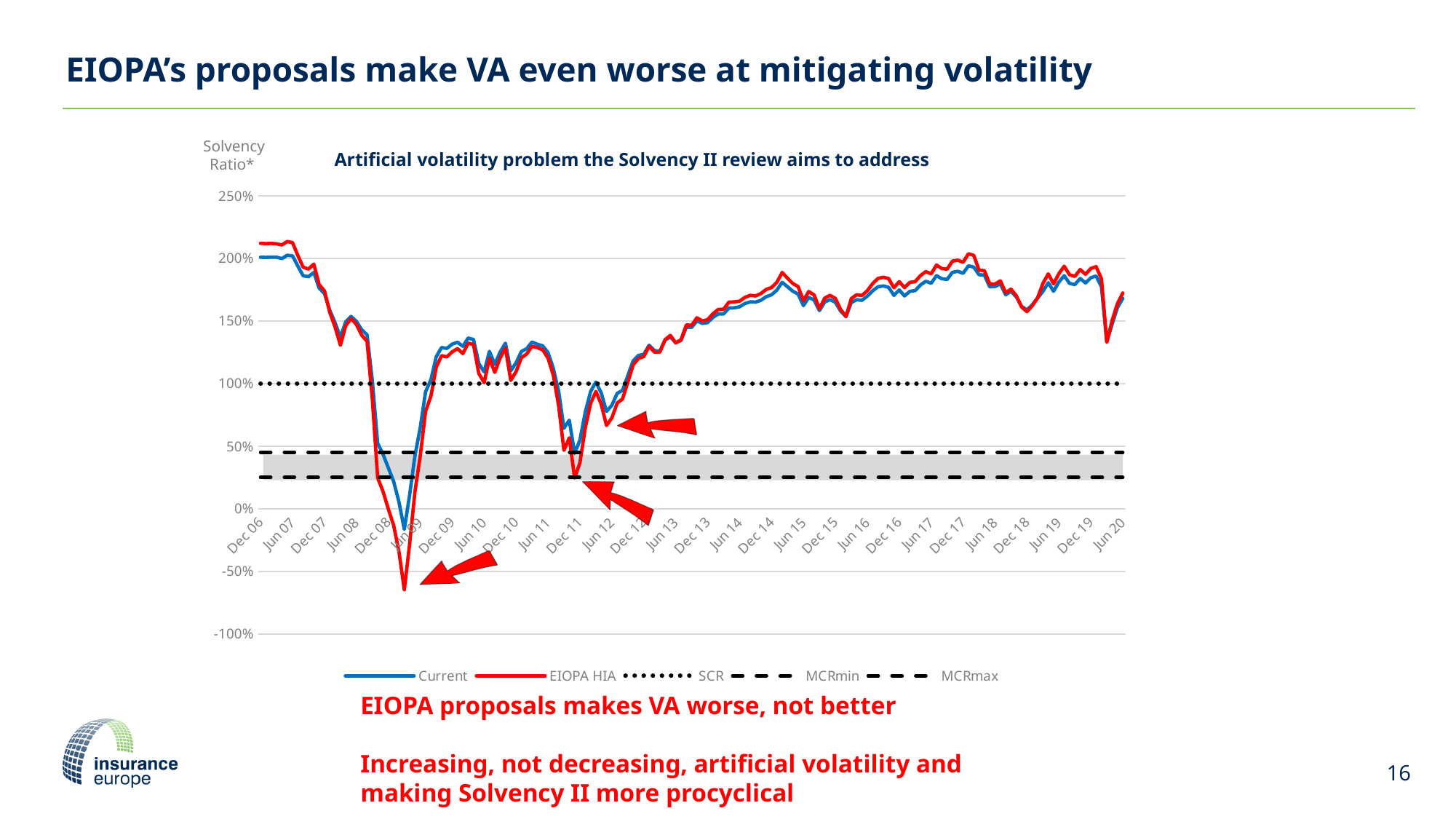
How many series does the chart legend list? 5 Between Jun 12 and Dec 14, do the Current and EIOPA HIA series generally rise or fall? rise At what level on the y axis is the SCR dotted line drawn? 100% Is the lowest value of the EIOPA HIA series (around Jun 09) greater or less than -50%? less Which colour is used for the Current series in the chart? blue Is the value of the Current series at Dec 06 greater or less than 150%? greater What is the title of the chart? Artificial volatility problem the Solvency II review aims to address At the trough around Jun 09, which series falls lower, Current or EIOPA HIA? EIOPA HIA At the peak around Jun 17, which series is higher, Current or EIOPA HIA? EIOPA HIA How many date labels are shown on the x axis? 28 Is the lowest value of the Current series (around Jun 09) greater or less than 50%? less What kind of chart is shown on the slide? line chart